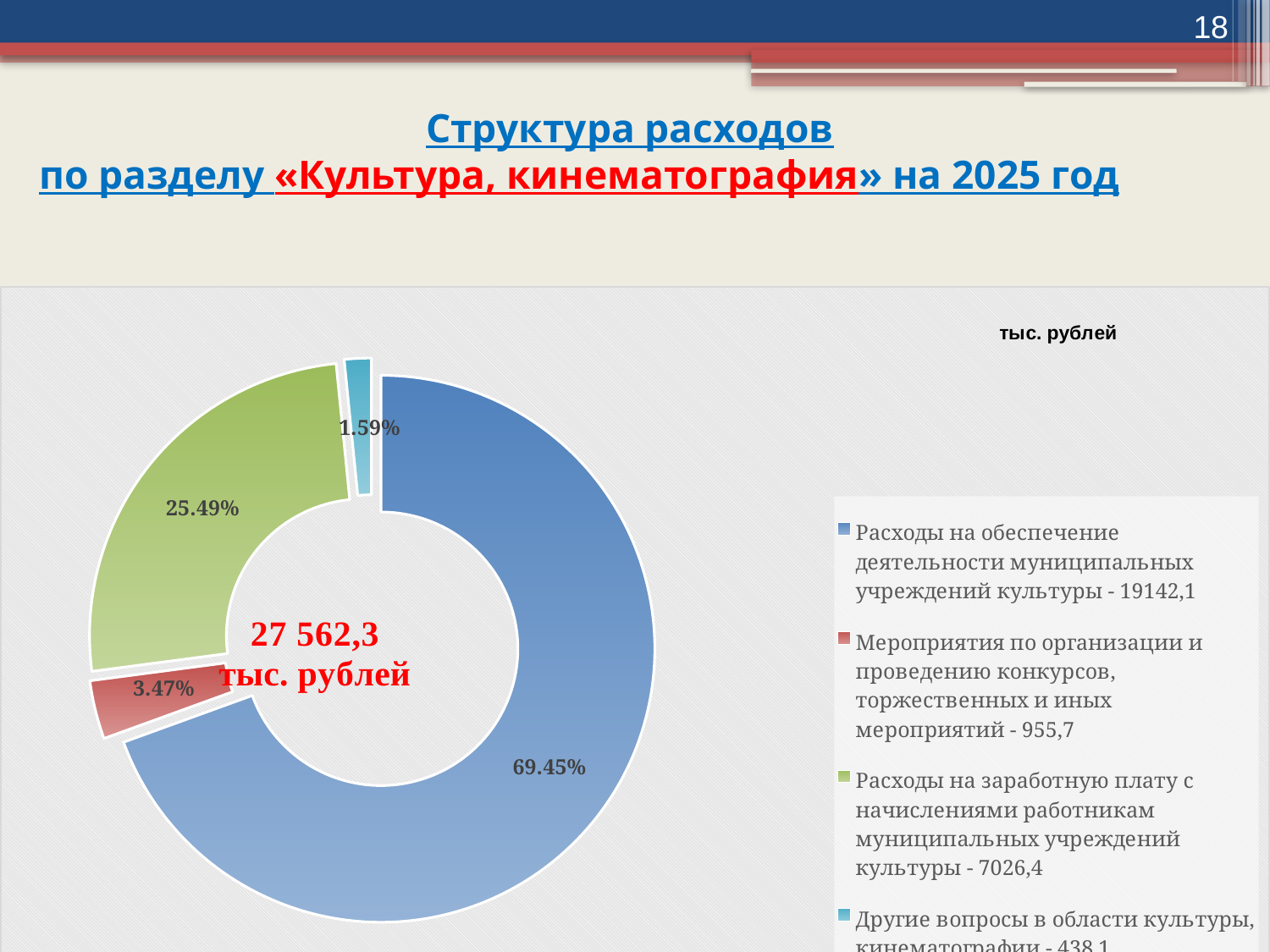
What share of the chart does the slice for «Другие вопросы в области культуры, кинематографии» represent? 1.59% What kind of chart is shown on the slide? doughnut (pie) chart What is the difference in percentage points between the largest slice (69.45%) and the slice for «Расходы на заработную плату...» (25.49%)? 43.96 percentage points What total amount is printed in the centre of the doughnut chart? 27 562,3 тыс. рублей According to the legend, what is the value (тыс. рублей) for «Расходы на заработную плату с начислениями работникам муниципальных учреждений культуры»? 7026,4 What share of the chart does the slice for «Мероприятия по организации и проведению конкурсов, торжественных и иных мероприятий» represent? 3.47% What share of the chart does the slice for «Расходы на заработную плату с начислениями работникам муниципальных учреждений культуры» represent? 25.49% Which category has the smallest slice in the chart? Другие вопросы в области культуры, кинематографии Which category has the largest slice in the chart? Расходы на обеспечение деятельности муниципальных учреждений культуры How many slices does the chart have? 4 According to the legend, what is the value (тыс. рублей) for «Мероприятия по организации и проведению конкурсов, торжественных и иных мероприятий»? 955,7